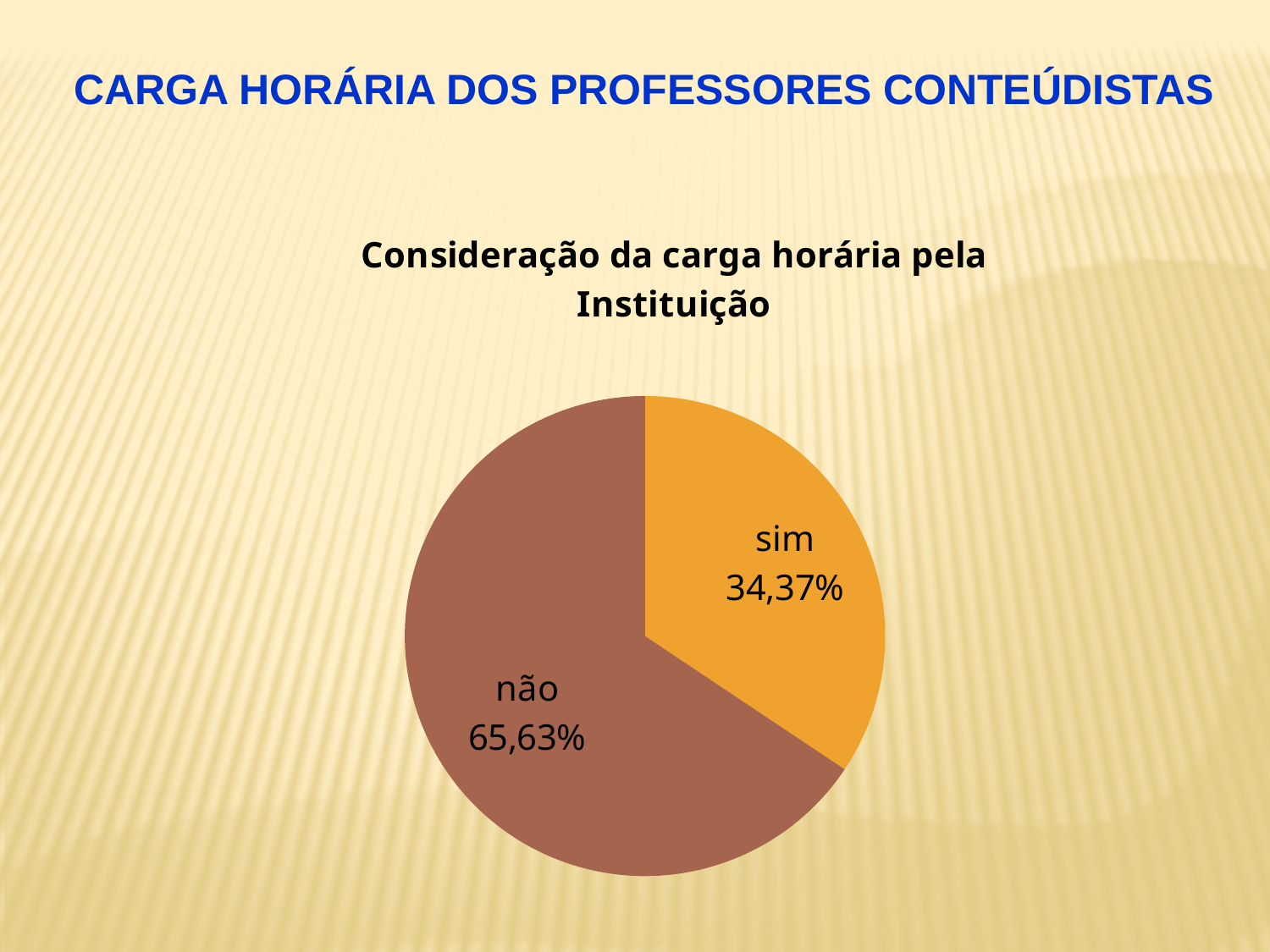
Which is larger, the "sim" slice or the "não" slice? não What percentage does the "não" slice represent? 65,63% What is the title of the chart? Consideração da carga horária pela Instituição What colour is the "não" slice? brown Which slice is the smallest in the pie chart? sim What is the difference in percentage points between the "não" and "sim" slices? 31,26 What share of the pie does the "sim" slice take? 34,37% What percentage does the "sim" slice represent? 34,37% What kind of chart is shown on the slide? pie chart Which slice is the largest in the pie chart? não How many slices does the pie chart have? 2